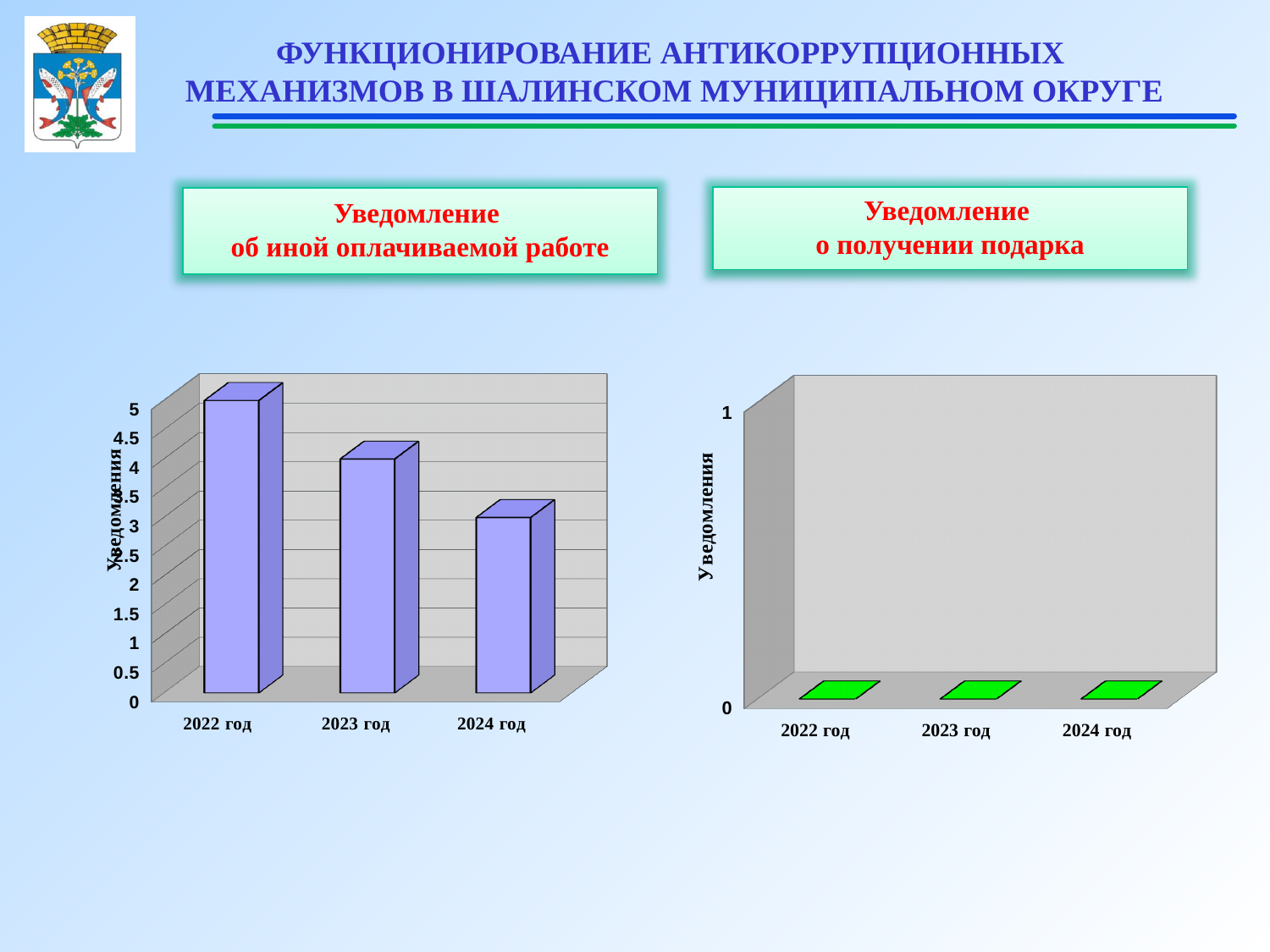
In the left chart (Уведомление об иной оплачиваемой работе), what is the difference between the values for 2022 год and 2024 год? 2 In the right chart (Уведомление о получении подарка), what is the value for 2023 год? 0 In the left chart (Уведомление об иной оплачиваемой работе), which year has the highest value? 2022 год In the left chart (Уведомление об иной оплачиваемой работе), do the values rise or fall from 2022 год to 2024 год? fall In the left chart (Уведомление об иной оплачиваемой работе), which is larger, the value for 2023 год or 2024 год? 2023 год In the left chart (Уведомление об иной оплачиваемой работе), which year has the lowest value? 2024 год How many years are shown on the x axis of the left chart (Уведомление об иной оплачиваемой работе)? 3 In the left chart (Уведомление об иной оплачиваемой работе), what is the value for 2024 год? 3 In the left chart (Уведомление об иной оплачиваемой работе), what is the value for 2022 год? 5 In the left chart (Уведомление об иной оплачиваемой работе), what is the value for 2023 год? 4 What kind of chart is the left chart (Уведомление об иной оплачиваемой работе)? bar chart What is the label on the vertical axis of the right chart (Уведомление о получении подарка)? Уведомления